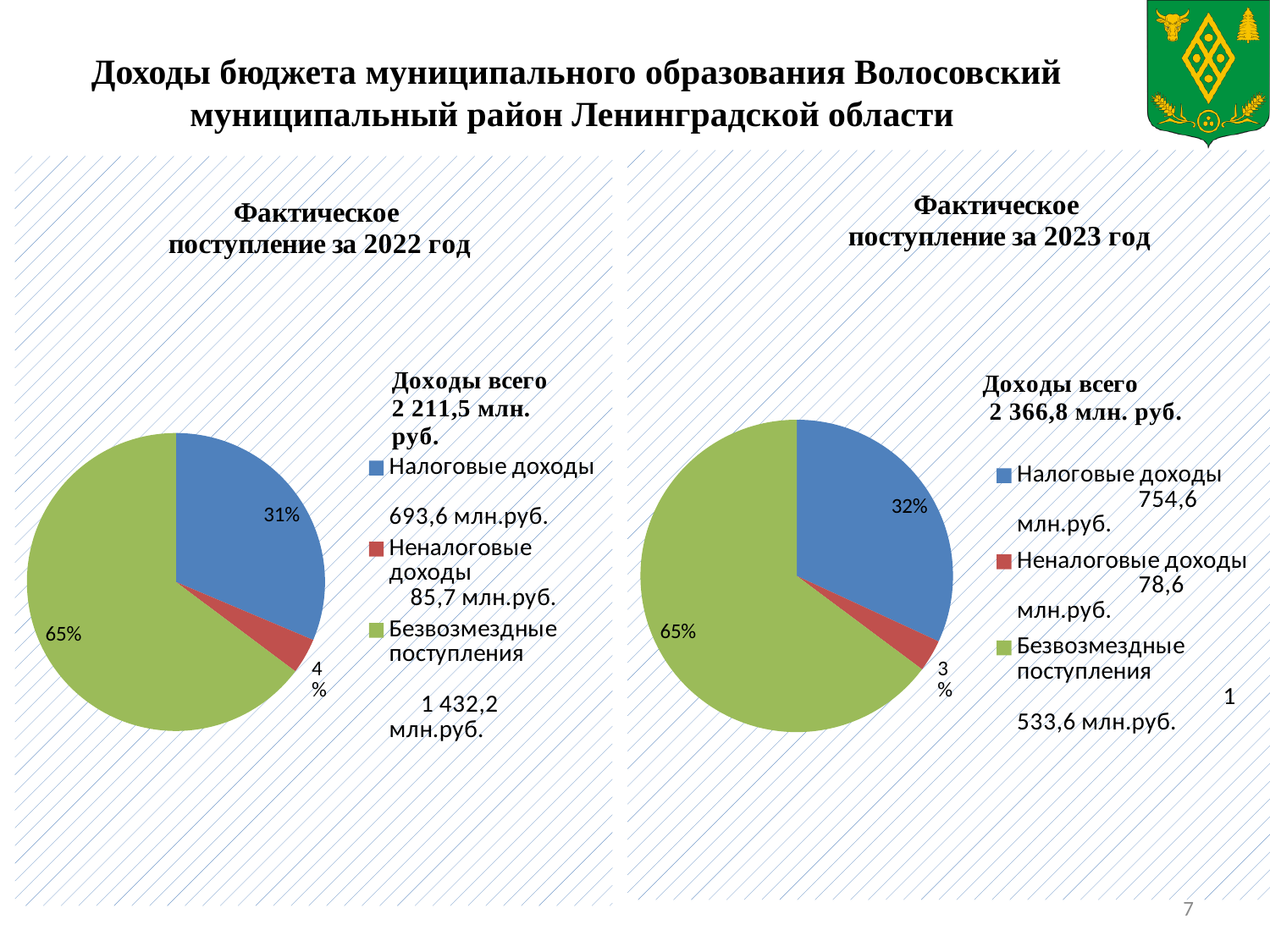
In the chart "Фактическое поступление за 2022 год", what share of the pie is "Безвозмездные поступления"? 65% What total income ("Доходы всего") is stated for the chart "Фактическое поступление за 2023 год"? 2 366,8 млн. руб. In the chart "Фактическое поступление за 2022 год", what is the value shown in the legend for "Неналоговые доходы"? 85,7 млн.руб. In the chart "Фактическое поступление за 2022 год", what share of the pie is "Налоговые доходы"? 31% Which is larger: "Налоговые доходы" in the 2022 chart or "Налоговые доходы" in the 2023 chart? 2023 (754,6 млн.руб.) What type of chart is used for "Фактическое поступление за 2022 год"? pie chart In the chart "Фактическое поступление за 2023 год", what is the value shown in the legend for "Безвозмездные поступления"? 1 533,6 млн.руб. In the chart "Фактическое поступление за 2023 год", what share of the pie is "Налоговые доходы"? 32% In the chart "Фактическое поступление за 2022 год", which category has the largest slice? Безвозмездные поступления In the chart "Фактическое поступление за 2023 год", how many categories does the legend list? 3 In the chart "Фактическое поступление за 2022 год", which category has the smallest slice? Неналоговые доходы